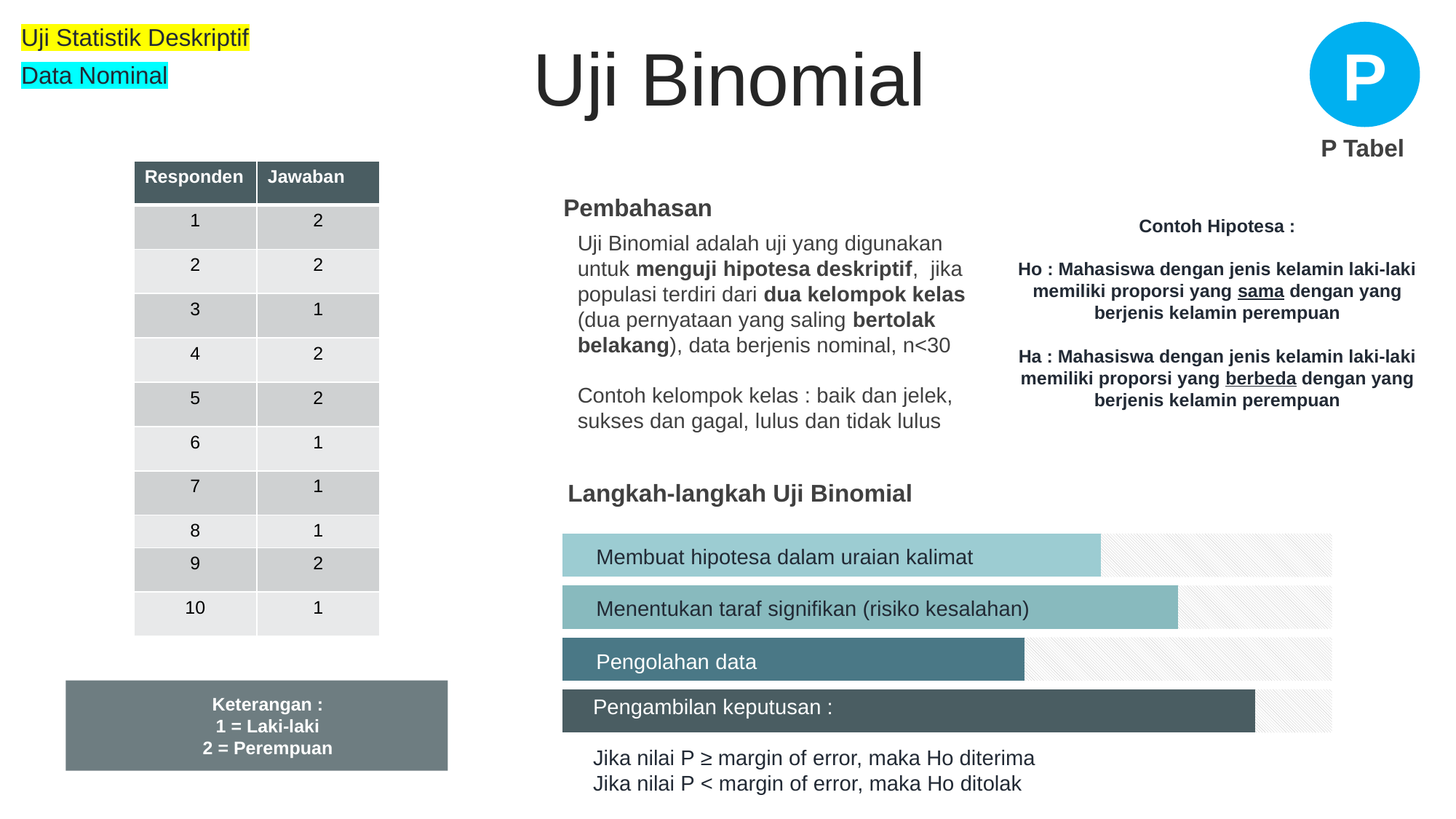
How many bars are shown in the 'Langkah-langkah Uji Binomial' bar graphic? 4 What is the label of the first (top) bar in the 'Langkah-langkah Uji Binomial' bar graphic? Membuat hipotesa dalam uraian kalimat What is the heading above the bar graphic on the slide? Langkah-langkah Uji Binomial What kind of chart is the 'Langkah-langkah Uji Binomial' graphic? bar chart In the 'Langkah-langkah Uji Binomial' bar graphic, which bar is longer: 'Membuat hipotesa dalam uraian kalimat' or 'Menentukan taraf signifikan (risiko kesalahan)'? Menentukan taraf signifikan (risiko kesalahan) In the 'Langkah-langkah Uji Binomial' bar graphic, which bar is the shortest? Pengolahan data In the 'Langkah-langkah Uji Binomial' bar graphic, which bar is longer: 'Pengolahan data' or 'Pengambilan keputusan :'? Pengambilan keputusan : In the 'Langkah-langkah Uji Binomial' bar graphic, which bar is the longest? Pengambilan keputusan :